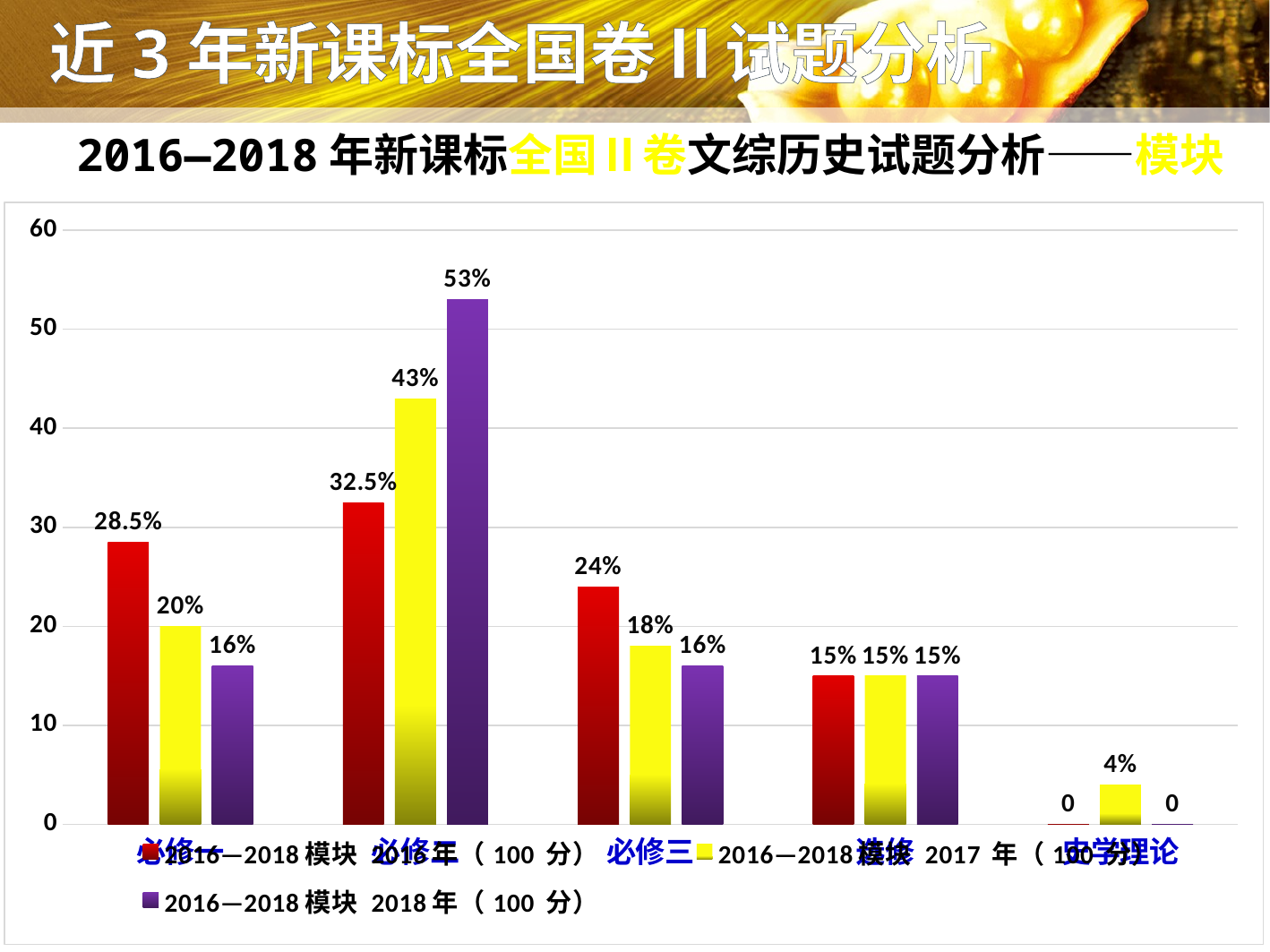
How many categories are shown along the x axis? 5 How many series does the legend list? 3 What type of chart is shown on the slide? bar chart What is the value of the 2017年 (yellow) bar for 史学理论? 4% What is the value of the 2018年 (purple) bar for 必修二? 53% What is the difference between the 2018年 (purple) and 2016年 (red) values for 必修二? 20.5% Across the three years, do the values for 必修二 rise or fall from 2016年 to 2018年? rise What value do all three bars for 选修 share? 15% Which category has the lowest 2017年 (yellow) bar? 史学理论 Which category has the highest 2018年 (purple) bar? 必修二 What is the value of the 2016年 (red) bar for 必修一? 28.5% For 必修三, which is larger: the 2016年 (red) bar or the 2017年 (yellow) bar? 2016年 (red)